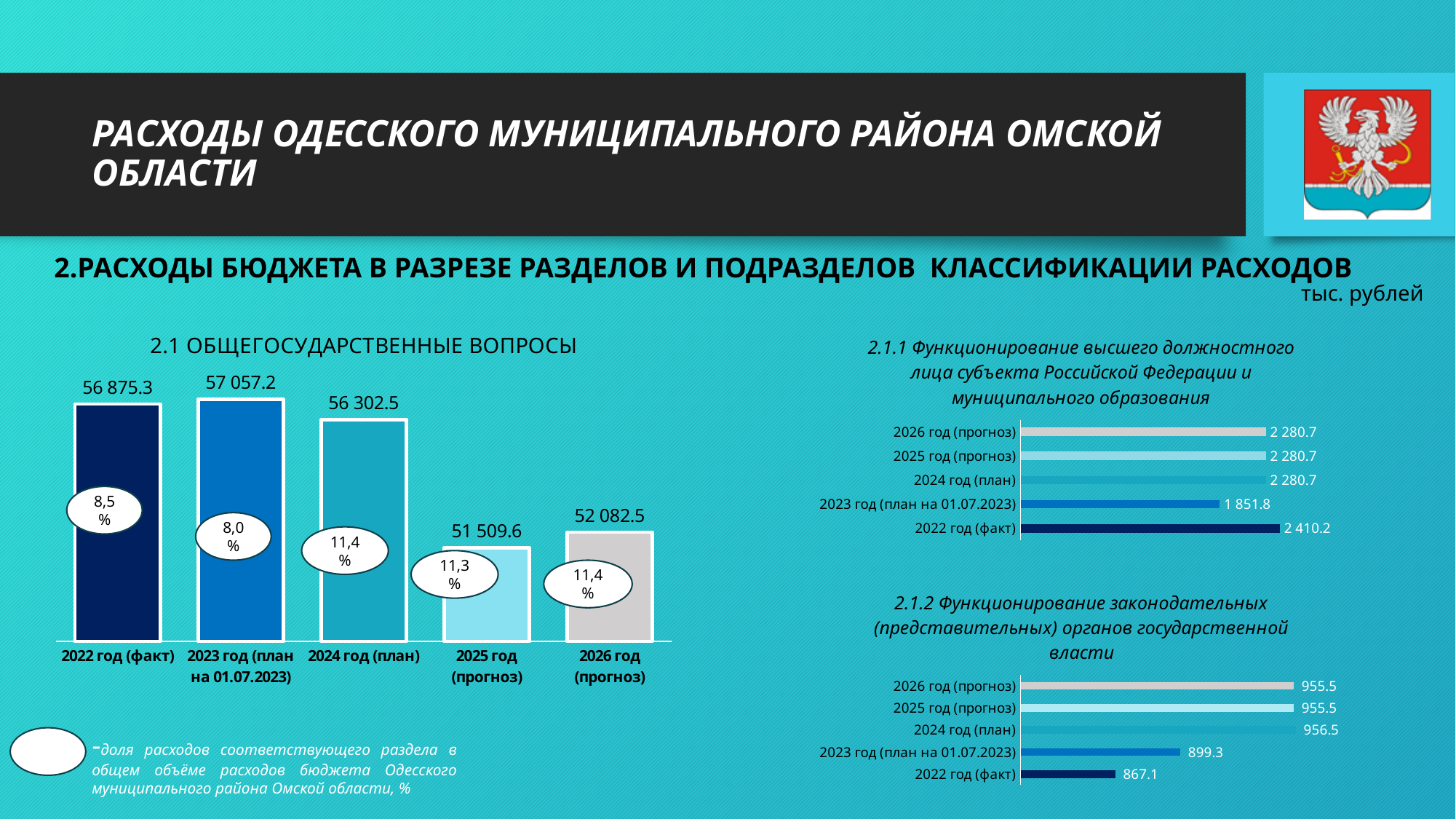
On the chart "2.1 ОБЩЕГОСУДАРСТВЕННЫЕ ВОПРОСЫ", which category has the lowest value? 2025 год (прогноз) On the chart "2.1.2 Функционирование законодательных (представительных) органов государственной власти", which category has the lowest value? 2022 год (факт) What kind of chart is "2.1.1 Функционирование высшего должностного лица субъекта Российской Федерации и муниципального образования"? bar chart On the chart "2.1.1 Функционирование высшего должностного лица...", which category has the highest value? 2022 год (факт) On the chart "2.1 ОБЩЕГОСУДАРСТВЕННЫЕ ВОПРОСЫ", what is the difference between the values for 2023 год (план на 01.07.2023) and 2022 год (факт)? 181.9 On the chart "2.1.2 Функционирование законодательных (представительных) органов государственной власти", which is larger: the value for 2024 год (план) or 2023 год (план на 01.07.2023)? 2024 год (план) On the chart "2.1.1 Функционирование высшего должностного лица...", what is the difference between the values for 2022 год (факт) and 2023 год (план на 01.07.2023)? 558.4 On the chart "2.1.1 Функционирование высшего должностного лица...", what is the value for 2023 год (план на 01.07.2023)? 1 851.8 On the chart "2.1 ОБЩЕГОСУДАРСТВЕННЫЕ ВОПРОСЫ", what share percentage is shown inside the bar for 2025 год (прогноз)? 11,3 % On the chart "2.1 ОБЩЕГОСУДАРСТВЕННЫЕ ВОПРОСЫ", what is the value for 2024 год (план)? 56 302.5 On the chart "2.1 ОБЩЕГОСУДАРСТВЕННЫЕ ВОПРОСЫ", which category has the highest value? 2023 год (план на 01.07.2023) How many bars are on the chart "2.1 ОБЩЕГОСУДАРСТВЕННЫЕ ВОПРОСЫ"? 5